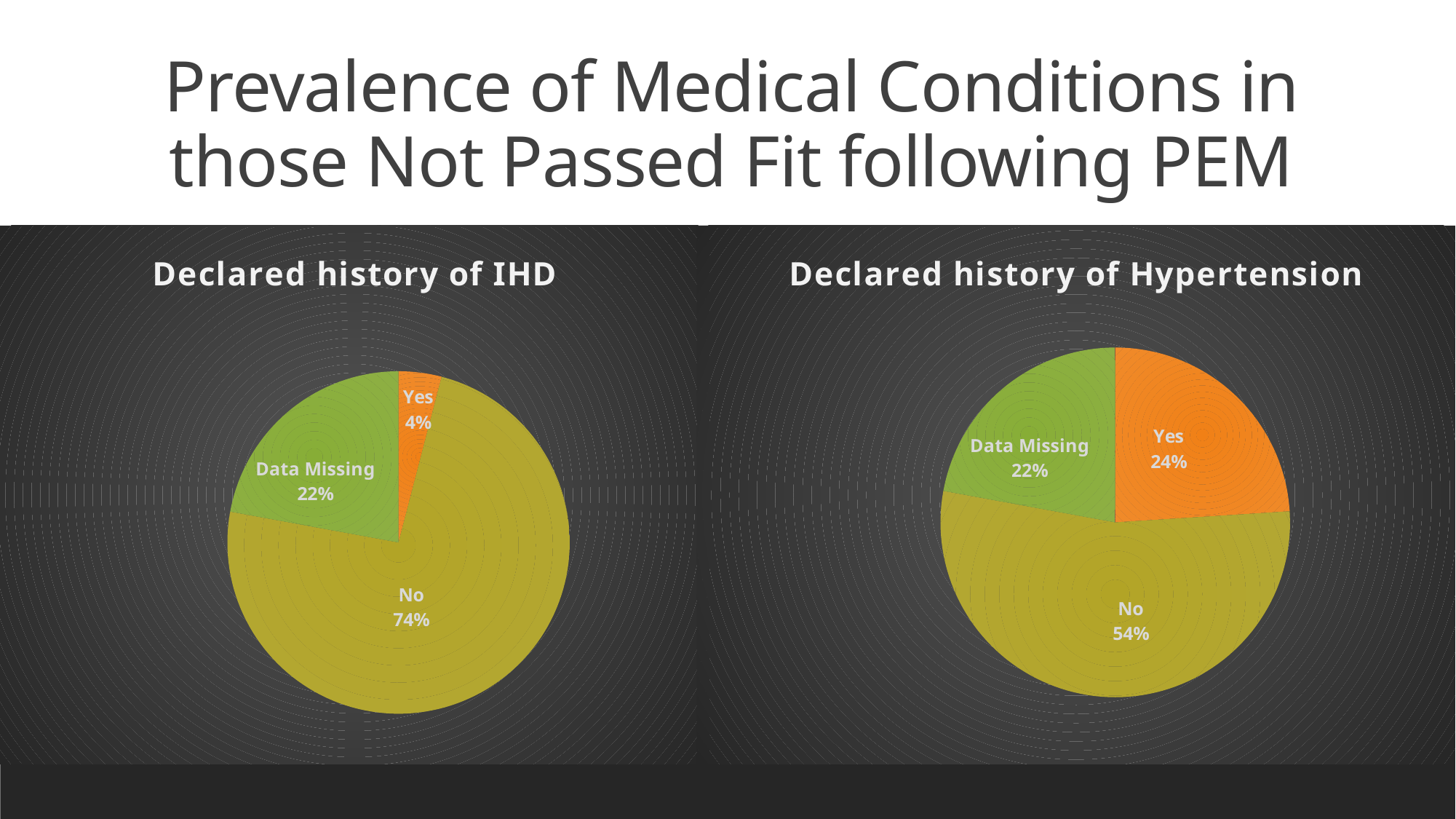
In the 'Declared history of Hypertension' chart, which slice is the largest? No In the 'Declared history of IHD' chart, which slice is the smallest? Yes In the 'Declared history of Hypertension' chart, what is the difference between the 'No' and 'Yes' shares? 30% How many slices does the 'Declared history of IHD' chart have? 3 In the 'Declared history of Hypertension' chart, what share of the pie is 'No'? 54% In the 'Declared history of Hypertension' chart, what share of the pie is 'Yes'? 24% In the 'Declared history of IHD' chart, what share of the pie is 'Yes'? 4% Which chart has the larger 'Yes' share, 'Declared history of IHD' or 'Declared history of Hypertension'? Declared history of Hypertension In the 'Declared history of IHD' chart, what is the difference between the 'No' and 'Data Missing' shares? 52% What kind of chart is the 'Declared history of Hypertension' chart? Pie chart